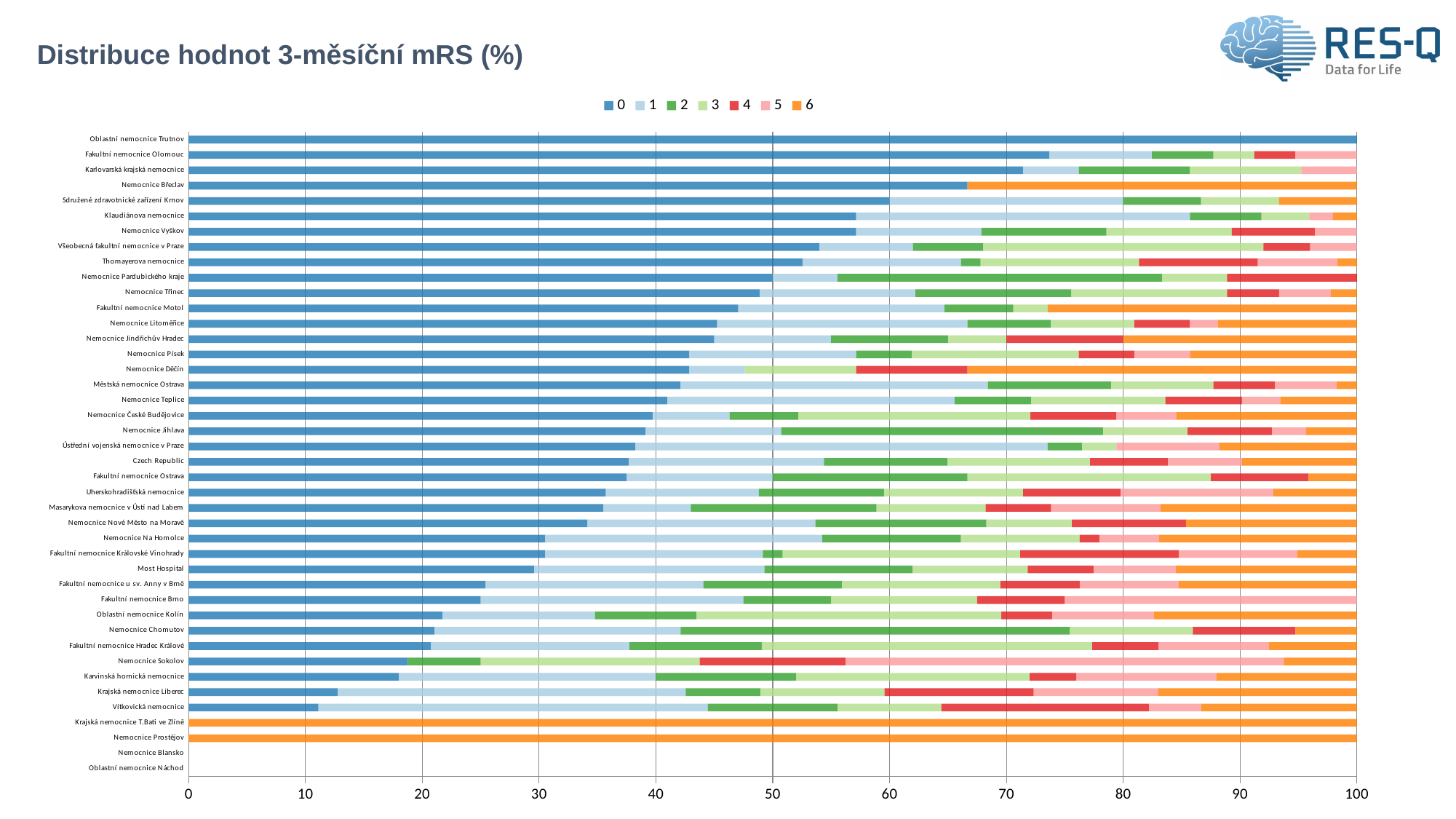
What is the value of series 0 for Oblastní nemocnice Trutnov? 100 What is the value of series 6 for Nemocnice Prostějov? 100 What kind of chart is shown on the slide? Stacked bar chart Which series is shown in orange in the legend? 6 Is the value of series 0 for Nemocnice Břeclav greater or less than 60? greater Which hospital has the highest value for series 0? Oblastní nemocnice Trutnov What is the title of the chart? Distribuce hodnot 3-měsíční mRS (%) Which has a larger value for series 0: Oblastní nemocnice Trutnov or Karvinská hornická nemocnice? Oblastní nemocnice Trutnov Is the value of series 0 for Fakultní nemocnice Olomouc greater or less than 70? greater How many series does the legend list? 7 Is the value of series 0 for Vítkovická nemocnice greater or less than 20? less What is the total of the stacked bar for Fakultní nemocnice Olomouc? 100